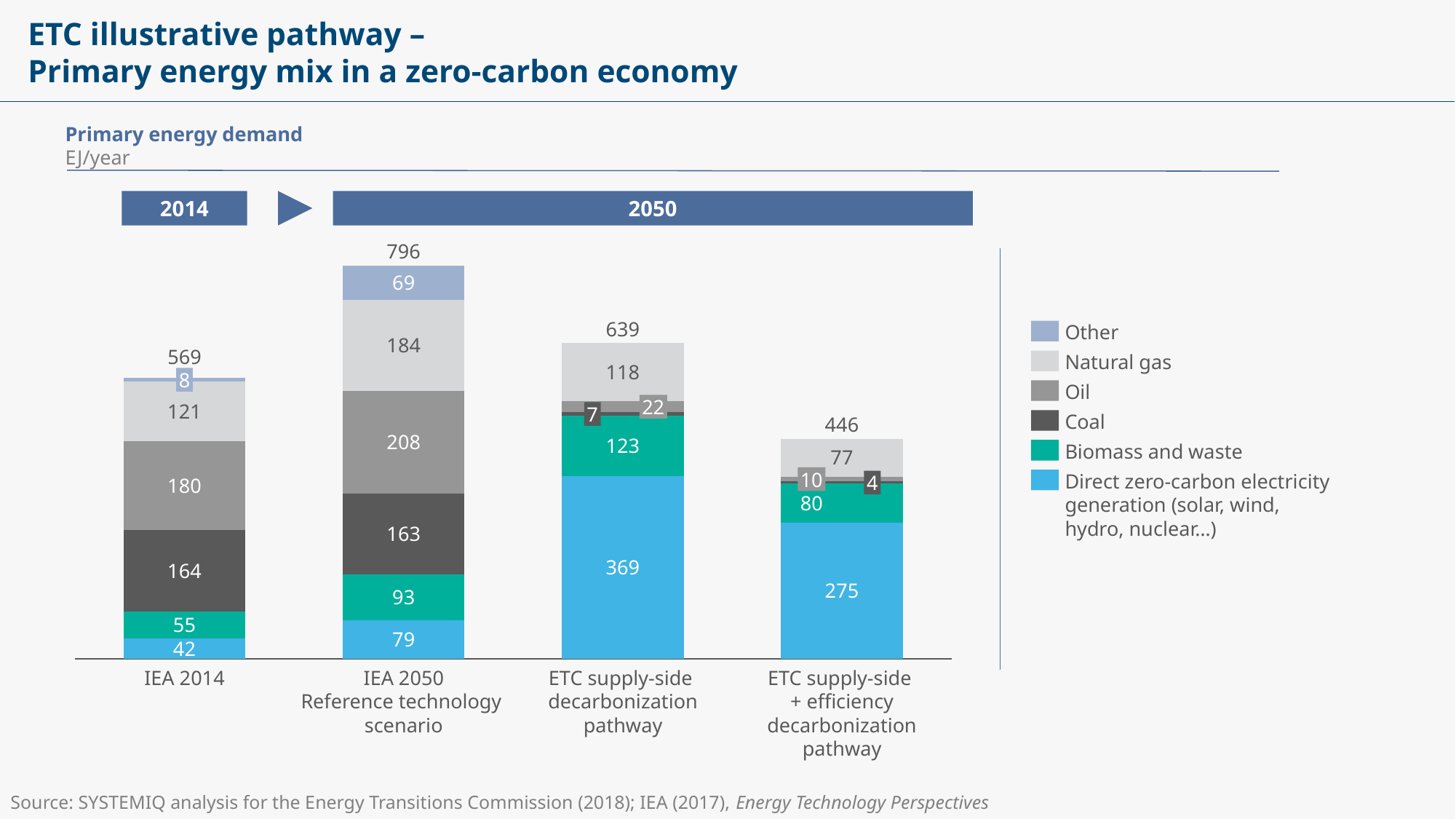
What is the value for Natural gas in the ETC supply-side + efficiency decarbonization pathway? 77 What is the value for Coal in the IEA 2014 bar? 164 What is the value for Direct zero-carbon electricity generation in the ETC supply-side decarbonization pathway? 369 Which is larger: Oil in IEA 2014 or Oil in the IEA 2050 Reference technology scenario? IEA 2050 Reference technology scenario Which scenario has the lowest total primary energy demand? ETC supply-side + efficiency decarbonization pathway What unit is the primary energy demand measured in? EJ/year How many series does the legend list? 6 What is the total primary energy demand for the IEA 2050 Reference technology scenario? 796 How many scenarios (bars) are shown on the chart? 4 What kind of chart is shown on the slide? Stacked bar chart Which scenario has the highest total primary energy demand? IEA 2050 Reference technology scenario What is the difference between the total for IEA 2050 Reference technology scenario and the total for ETC supply-side + efficiency decarbonization pathway? 350